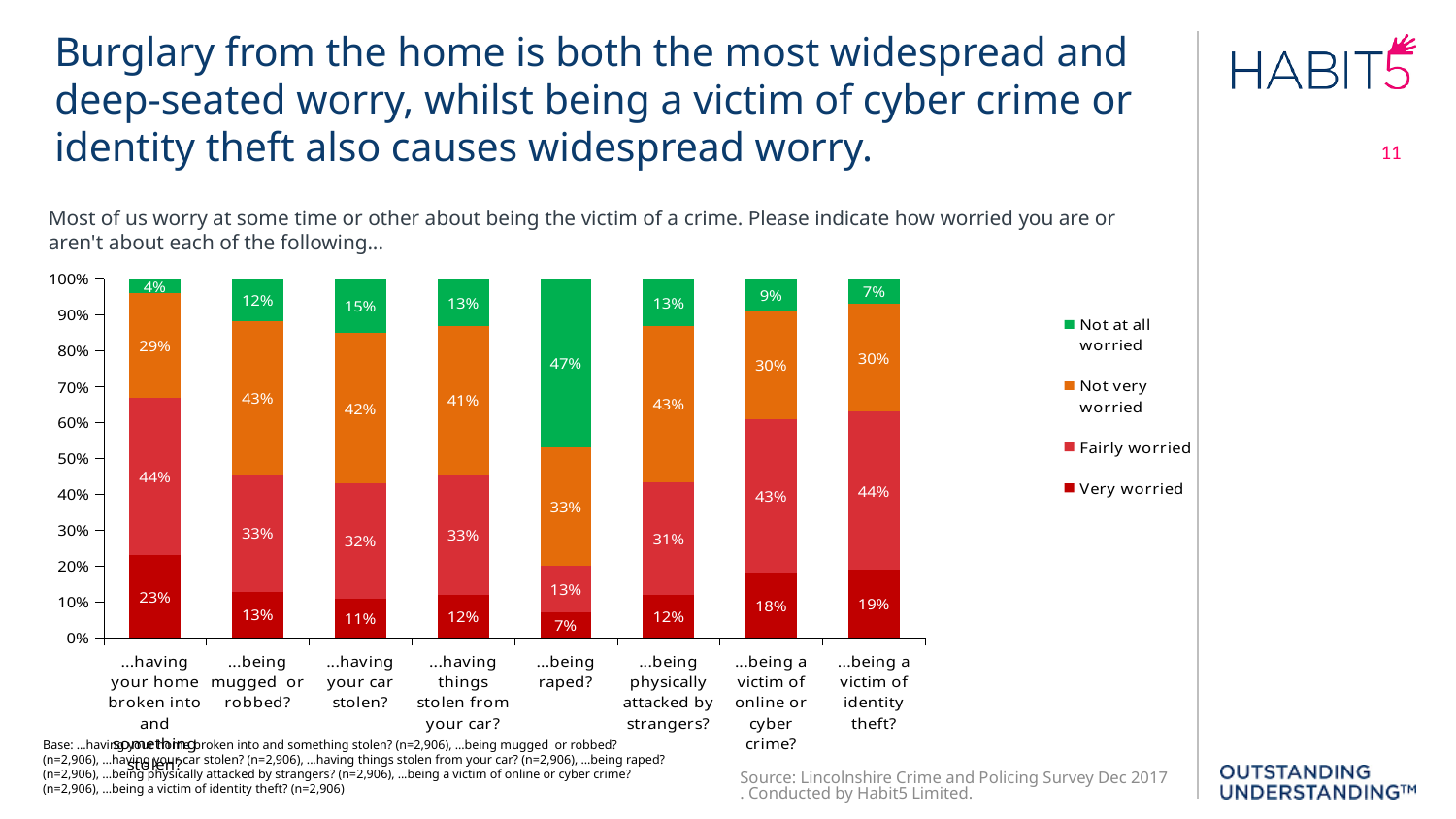
Which is larger: the "Not at all worried" percentage for having your car stolen or for having things stolen from your car? having your car stolen (15%) What percentage of respondents are "Not very worried" about being mugged or robbed? 43% How many crime categories are shown on the x axis? 8 What is the difference between the "Very worried" percentages for being a victim of identity theft and being a victim of online or cyber crime? 1% What kind of chart is shown on the slide? Stacked bar chart How many series does the legend list? 4 Which category has the lowest "Very worried" percentage? ...being raped? What is the combined percentage of "Very worried" and "Fairly worried" respondents for having your home broken into and something stolen? 67% Which category has the highest "Very worried" percentage? ...having your home broken into and something stolen? What percentage of respondents are "Not at all worried" about being raped? 47% What percentage of respondents are "Very worried" about having their home broken into and something stolen? 23% What percentage of respondents are "Fairly worried" about being a victim of identity theft? 44%